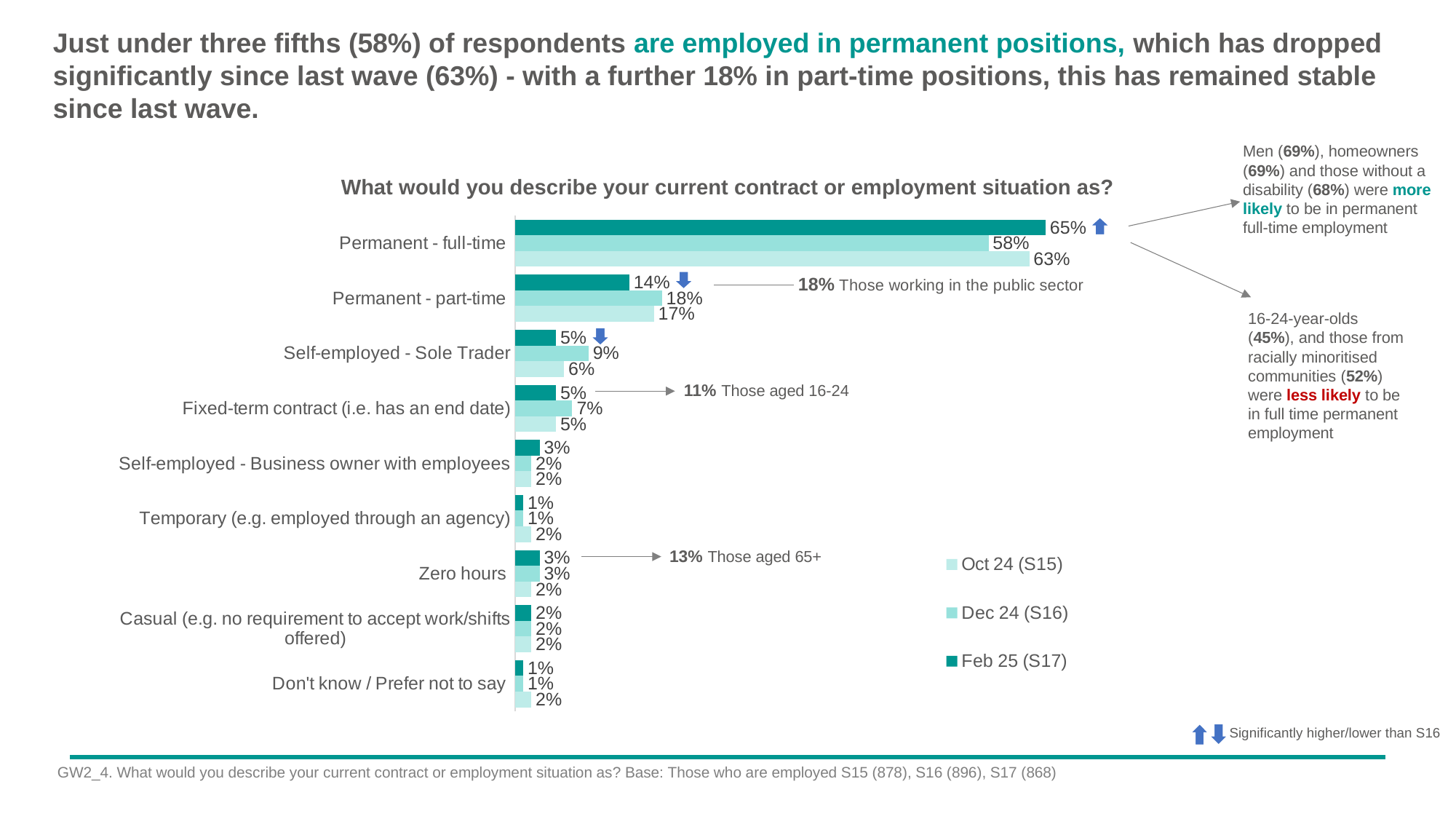
For Self-employed - Sole Trader, which is larger: the Dec 24 (S16) value or the Feb 25 (S17) value? Dec 24 (S16) Which category has the highest Feb 25 (S17) value? Permanent - full-time What is the title of the chart? What would you describe your current contract or employment situation as? What is the difference between the Feb 25 (S17) and Dec 24 (S16) values for Permanent - full-time? 7% What is the Dec 24 (S16) value for Permanent - part-time? 18% What kind of chart is shown on the slide? Bar chart What is the Feb 25 (S17) value for Permanent - full-time? 65% How many series does the legend list? 3 What is the difference between the Dec 24 (S16) and Feb 25 (S17) values for Permanent - part-time? 4% What is the Oct 24 (S15) value for Self-employed - Sole Trader? 6% What is the Dec 24 (S16) value for Fixed-term contract (i.e. has an end date)? 7% How many employment categories are shown on the chart? 9